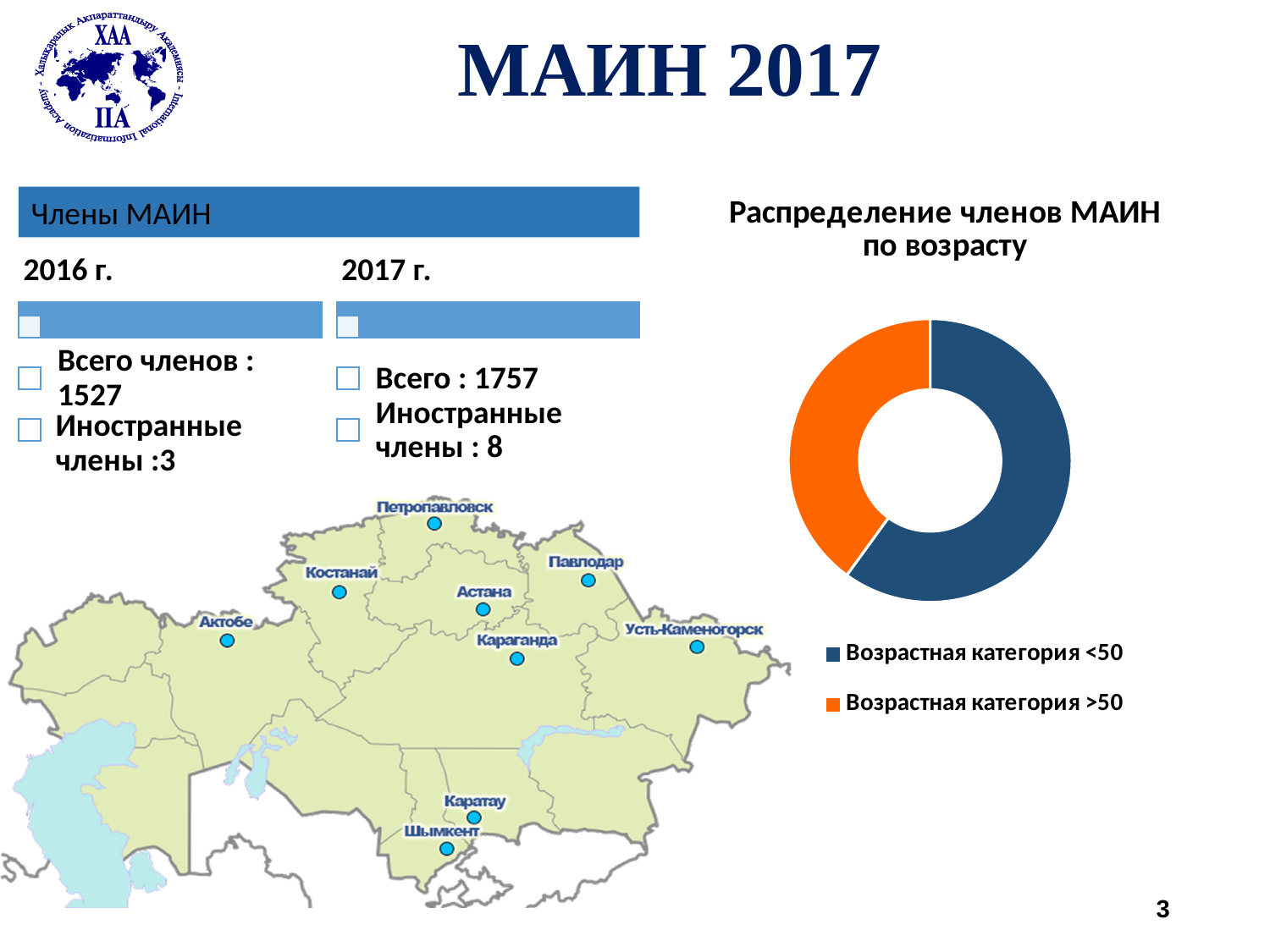
What is the title of the doughnut chart on the right of the slide? Распределение членов МАИН по возрасту What kind of chart is shown under the title "Распределение членов МАИН по возрасту"? Doughnut chart How many categories does the legend of the doughnut chart list? 2 Which age category takes the smallest share of the doughnut chart? Возрастная категория >50 In the doughnut chart, which is larger: the share for "Возрастная категория <50" or for "Возрастная категория >50"? Возрастная категория <50 Which age category takes the largest share of the doughnut chart? Возрастная категория <50 What colour represents "Возрастная категория >50" in the doughnut chart? Orange